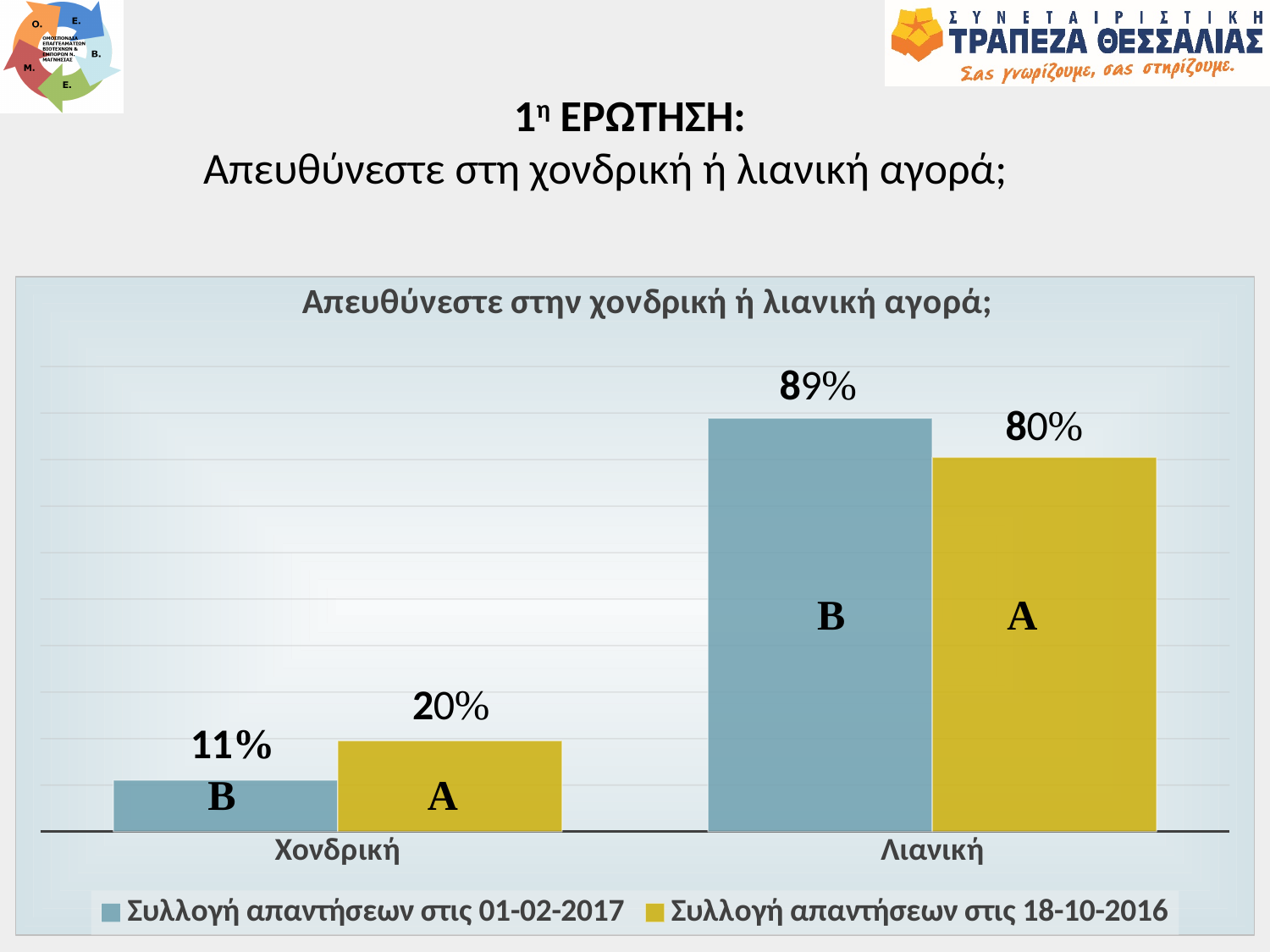
What is the value for Χονδρική in the series Συλλογή απαντήσεων στις 01-02-2017? 11% What kind of chart is shown on the slide? Bar chart What is the value for Λιανική in the series Συλλογή απαντήσεων στις 01-02-2017? 89% What is the value for Λιανική in the series Συλλογή απαντήσεων στις 18-10-2016? 80% What is the value for Χονδρική in the series Συλλογή απαντήσεων στις 18-10-2016? 20% For Χονδρική, which series has the larger value: 01-02-2017 or 18-10-2016? 18-10-2016 Which category has the highest value in the series Συλλογή απαντήσεων στις 01-02-2017? Λιανική How many categories are shown on the x axis? 2 What is the difference between the Χονδρική values of the two series? 9% Which category has the lowest value in the series Συλλογή απαντήσεων στις 18-10-2016? Χονδρική What is the difference between the Λιανική values of the two series? 9% How many series does the legend list? 2